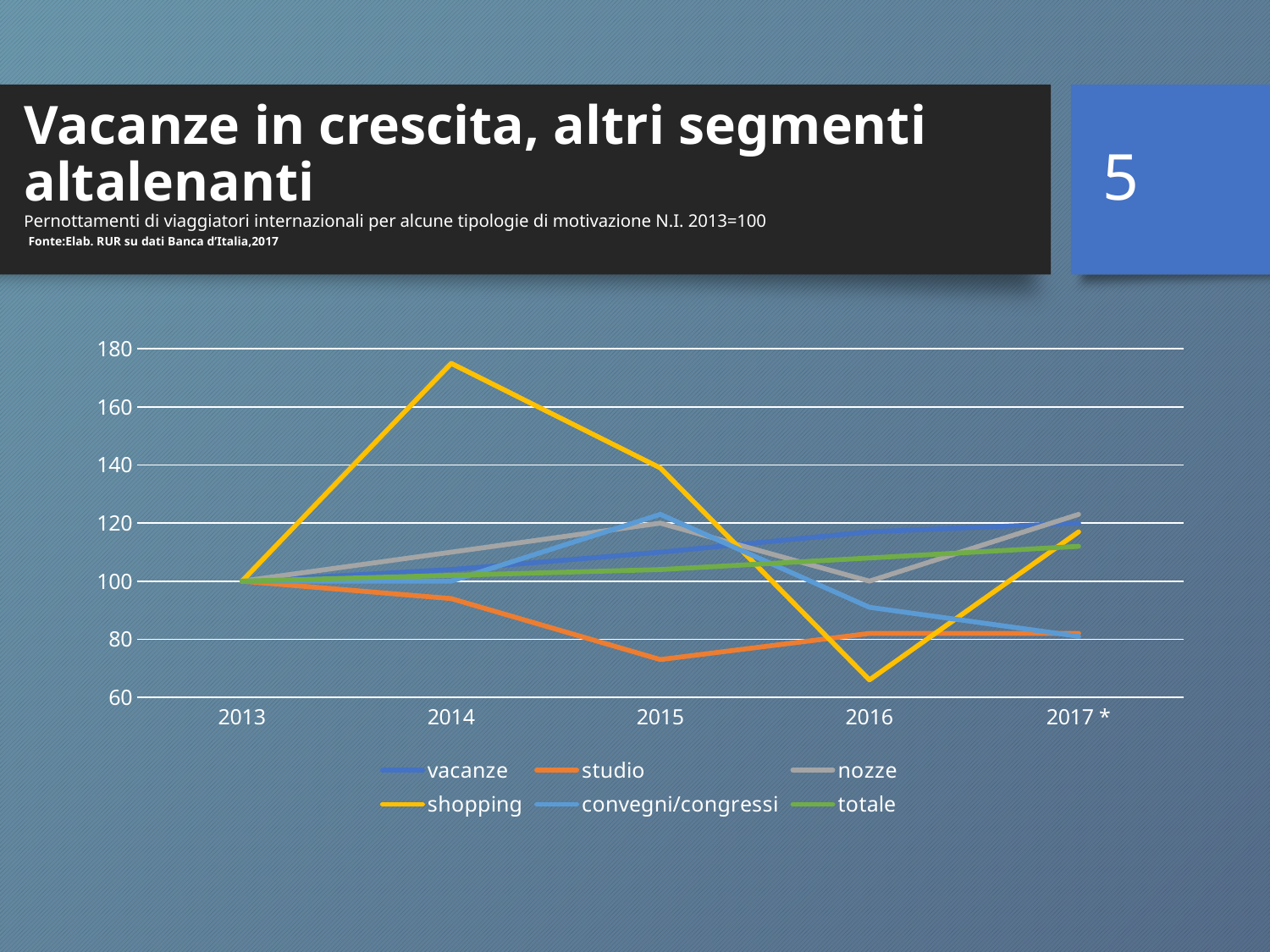
What is the value for shopping in 2013? 100 Is the value for shopping in 2016 greater or less than 80? less Does the totale series rise or fall from 2013 to 2017 *? rise How many years are shown on the x axis? 5 Which series has the highest value in 2014? shopping What kind of chart is shown on the slide? line chart Which series has the lowest value in 2016? shopping Is the value for shopping in 2014 greater or less than 160? greater What is the title of the slide? Vacanze in crescita, altri segmenti altalenanti In 2015, which is larger: the value for shopping or the value for studio? shopping How many series does the legend list? 6 Is the value for studio in 2015 greater or less than 80? less